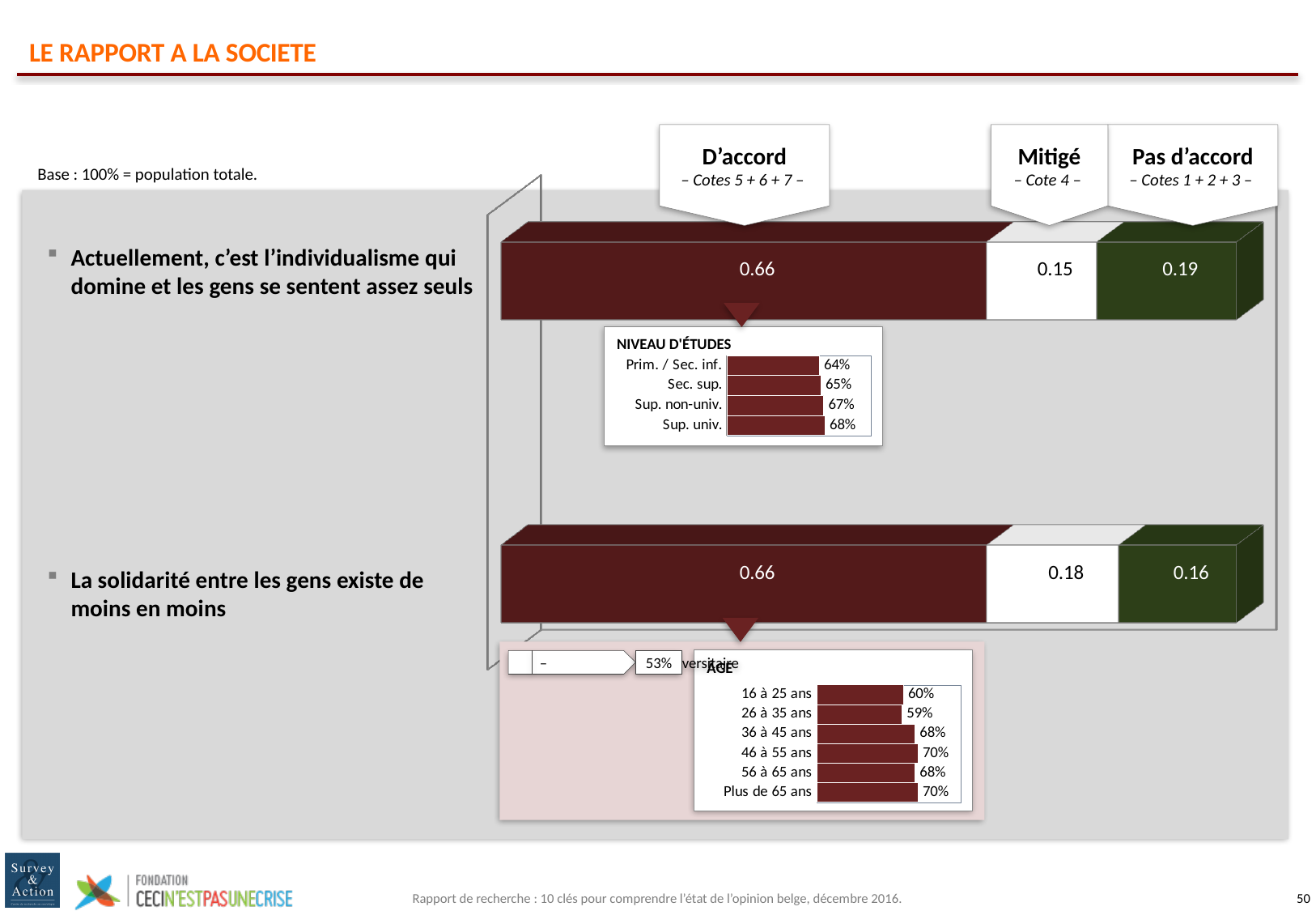
How many categories does the "NIVEAU D'ÉTUDES" chart show? 4 In the stacked bar for "Actuellement, c'est l'individualisme qui domine et les gens se sentent assez seuls", what is the value for "Pas d'accord"? 0.19 In the stacked bar for "La solidarité entre les gens existe de moins en moins", which segment is the smallest? Pas d'accord In the "NIVEAU D'ÉTUDES" chart, which category has the highest value? Sup. univ. In the stacked bar for "La solidarité entre les gens existe de moins en moins", what is the value for "Mitigé"? 0.18 How many categories does the "ÂGE" chart show? 6 In the "ÂGE" chart, what is the difference between "46 à 55 ans" and "16 à 25 ans"? 10% In the stacked bar for "Actuellement, c'est l'individualisme qui domine et les gens se sentent assez seuls", what is the value for "D'accord"? 0.66 In the "ÂGE" chart, which category has the lowest value? 26 à 35 ans In the stacked bar for "Actuellement, c'est l'individualisme qui domine et les gens se sentent assez seuls", what is the difference between the "Pas d'accord" and "Mitigé" values? 0.04 In the "NIVEAU D'ÉTUDES" chart, what is the value for "Sup. non-univ."? 67% In the "ÂGE" chart, what is the value for "26 à 35 ans"? 59%